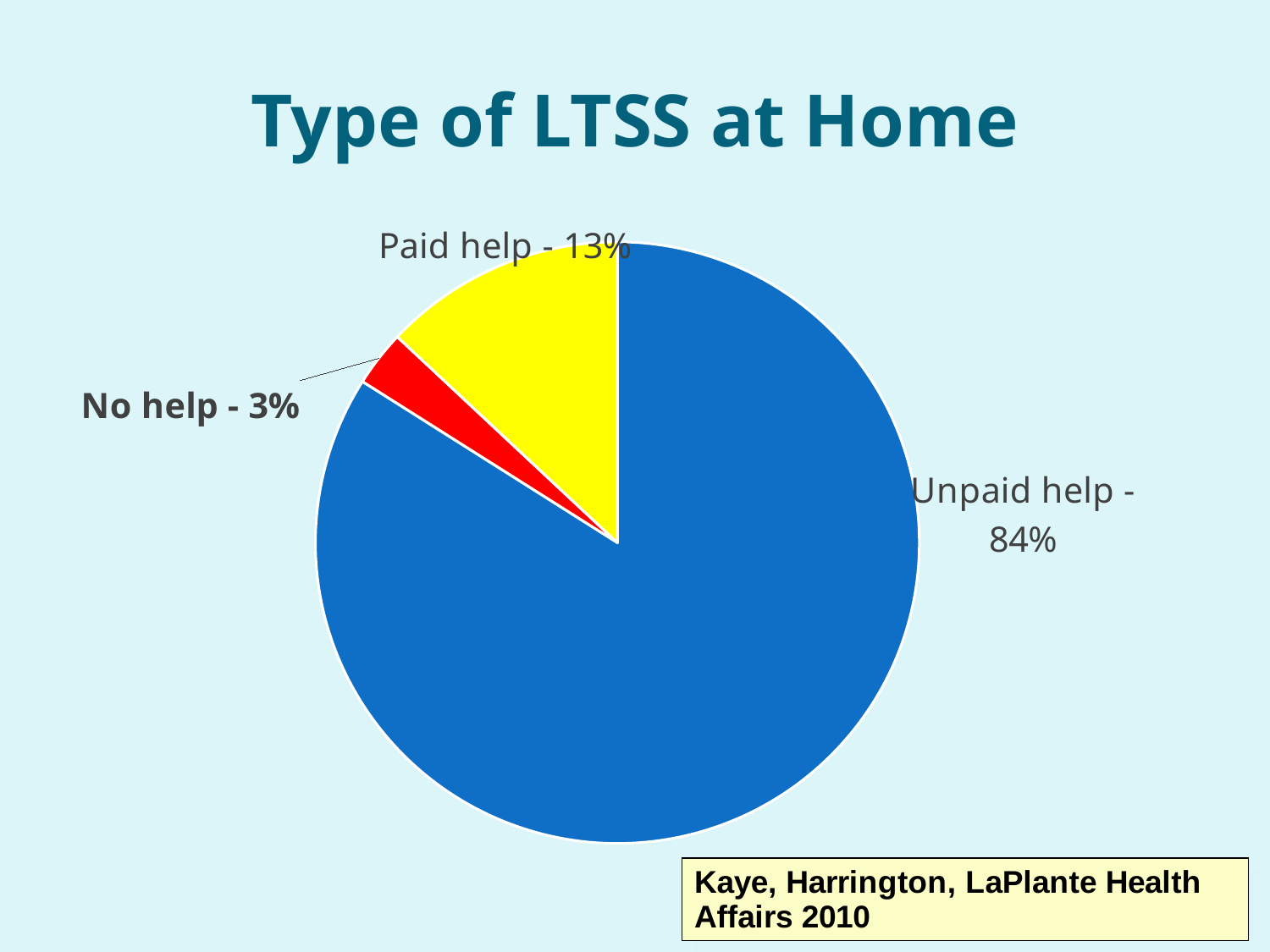
What is the difference in percentage points between Unpaid help and Paid help? 71 Which is larger, the share for Paid help or the share for No help? Paid help Which category has the smallest share of the pie? No help Which category has the largest share of the pie? Unpaid help What type of chart is shown on the slide? Pie chart What colour is the slice for No help? Red What is the title of the chart? Type of LTSS at Home What percentage of the pie is Paid help? 13% What is the difference in percentage points between Paid help and No help? 10 How many slices does the pie chart have? 3 What percentage of the pie is No help? 3% What percentage of the pie is Unpaid help? 84%